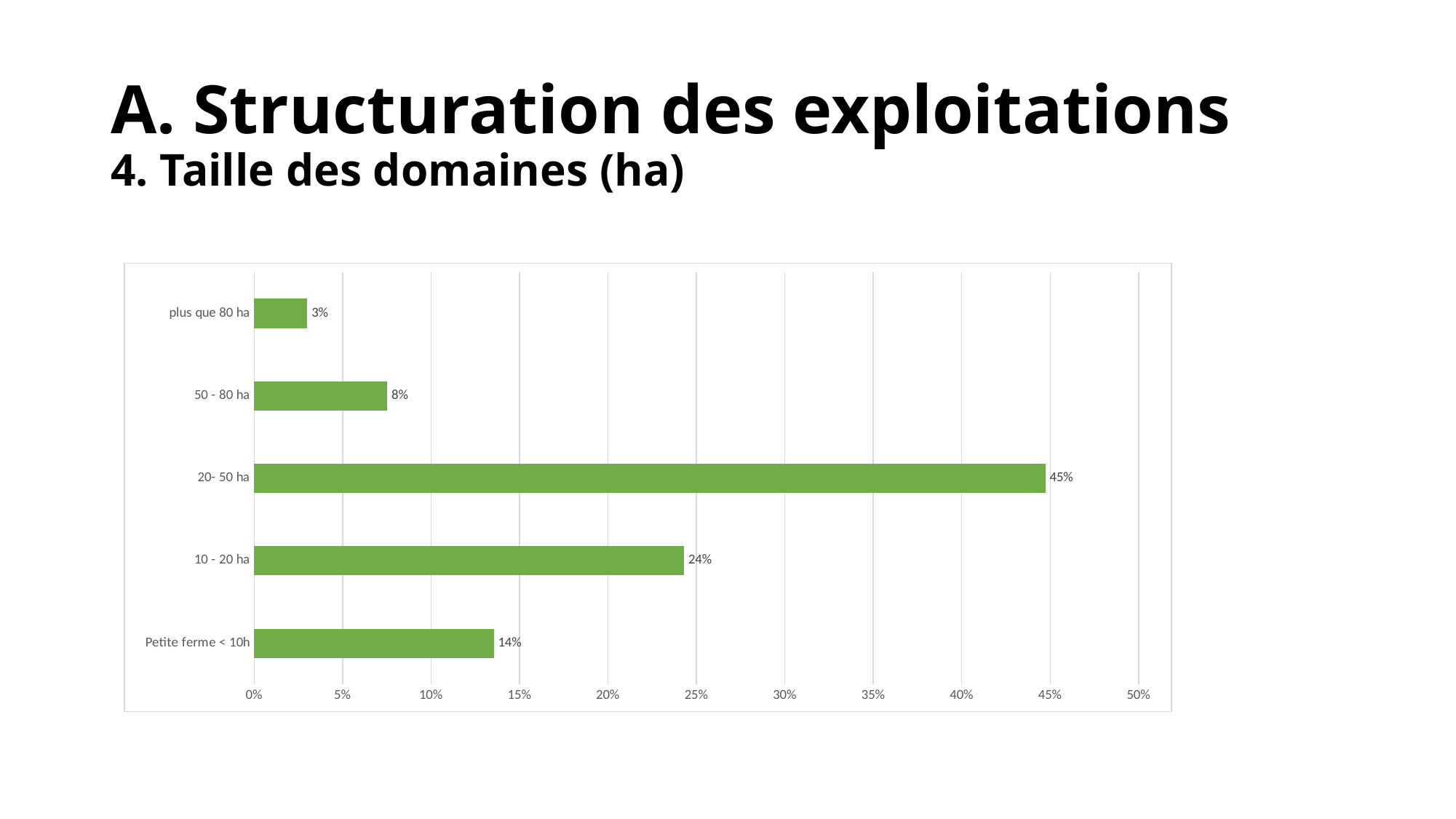
Which is larger, the value for 10 - 20 ha or the value for Petite ferme < 10h? 10 - 20 ha What is the value for 20- 50 ha? 45% What kind of chart is shown on the slide? bar chart Is the value for 10 - 20 ha greater or less than 20%? greater What is the difference between the values for 20- 50 ha and 10 - 20 ha? 21% How many categories are shown in the chart? 5 Which category has the lowest value? plus que 80 ha What colour are the bars in the chart? green Which category has the highest value? 20- 50 ha What is the value for 50 - 80 ha? 8% What is the value for plus que 80 ha? 3% What is the value for Petite ferme < 10h? 14%